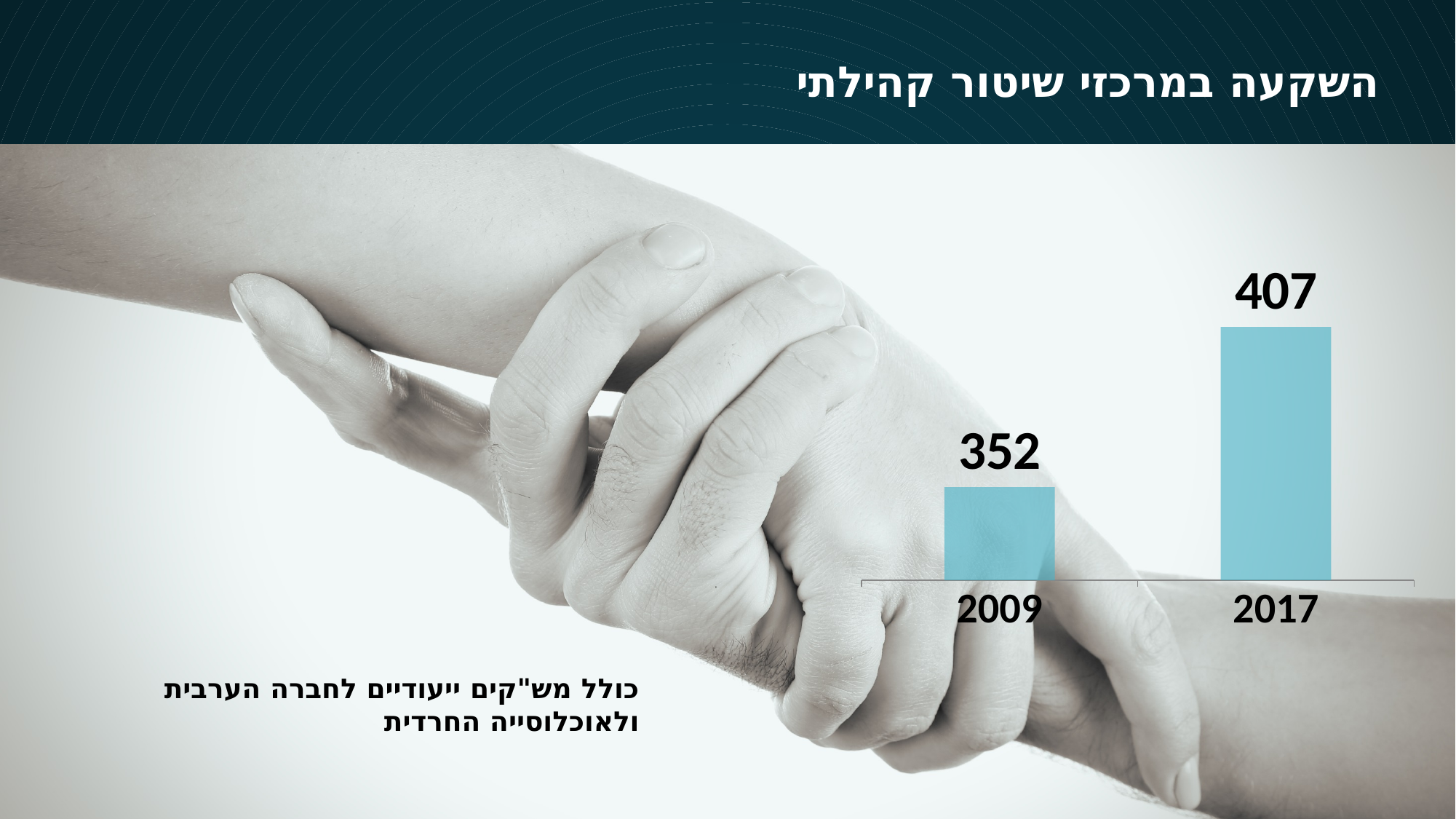
Which year has the higher value? 2017 What is the value for 2017? 407 What is the difference between the values for 2017 and 2009? 55 What is the title of the slide? השקעה במרכזי שיטור קהילתי Which year has the lower value? 2009 What is the value for 2009? 352 Is the value for 2017 larger than the value for 2009? Yes Do the values rise or fall from 2009 to 2017? Rise How many bars are shown in the chart? 2 What colour are the bars in the chart? Light blue What kind of chart is shown on the slide? Bar chart